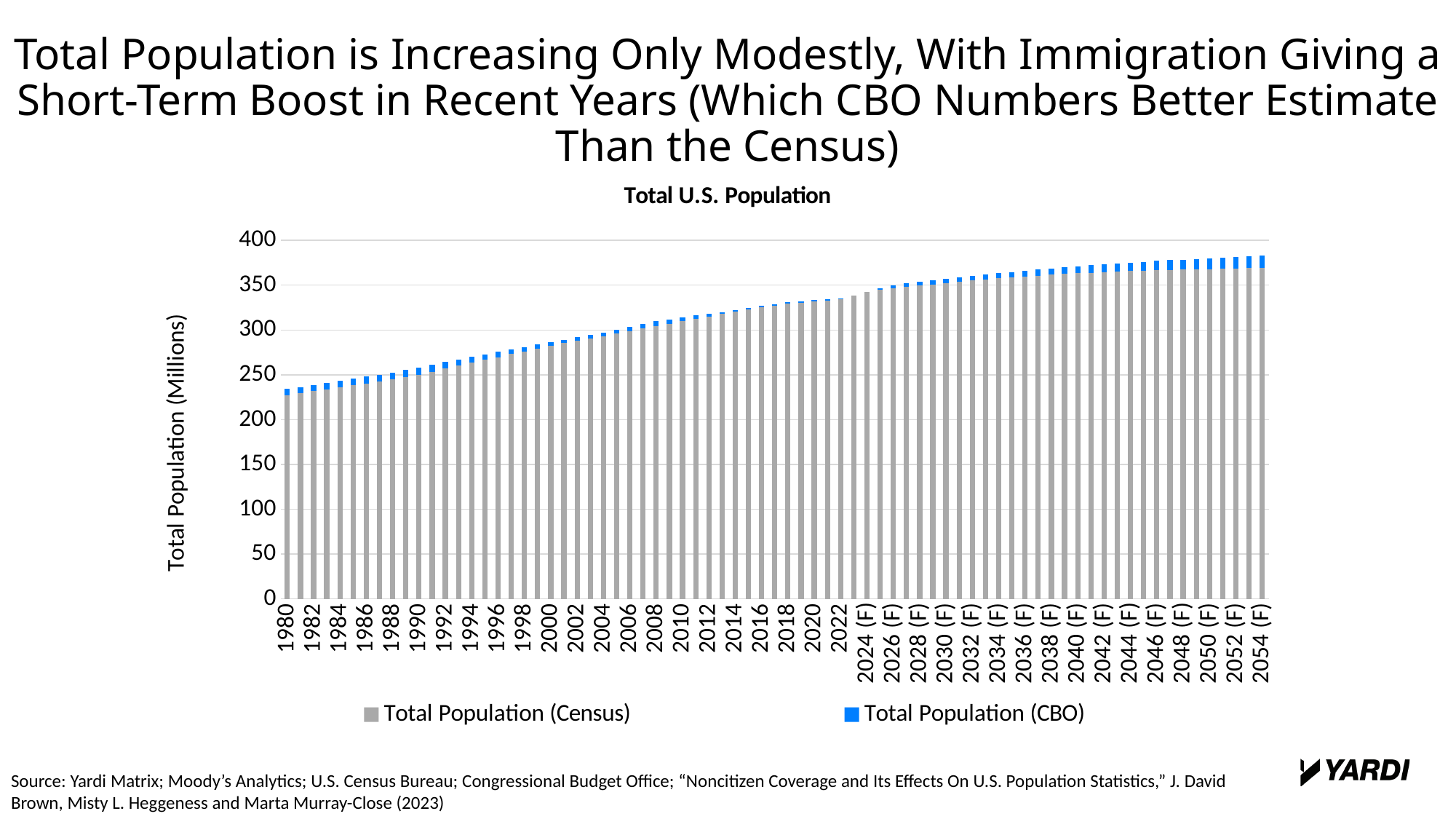
What are the two series named in the legend? Total Population (Census) and Total Population (CBO) Which year has a larger total population bar, 1990 or 2040 (F)? 2040 (F) Which year has the highest total population bar? 2054 (F) How many series does the chart's legend list? 2 Is the total population value for 2054 (F) greater or less than 350 million? greater Do the total population values rise or fall from 1980 to 2054 (F)? Rise What is the title of the chart? Total U.S. Population Is the total population value for 2020 greater or less than 300 million? greater Which year has the lowest total population bar? 1980 Is the total population value for 2000 greater or less than 300 million? less What kind of chart is shown on the slide? Bar chart